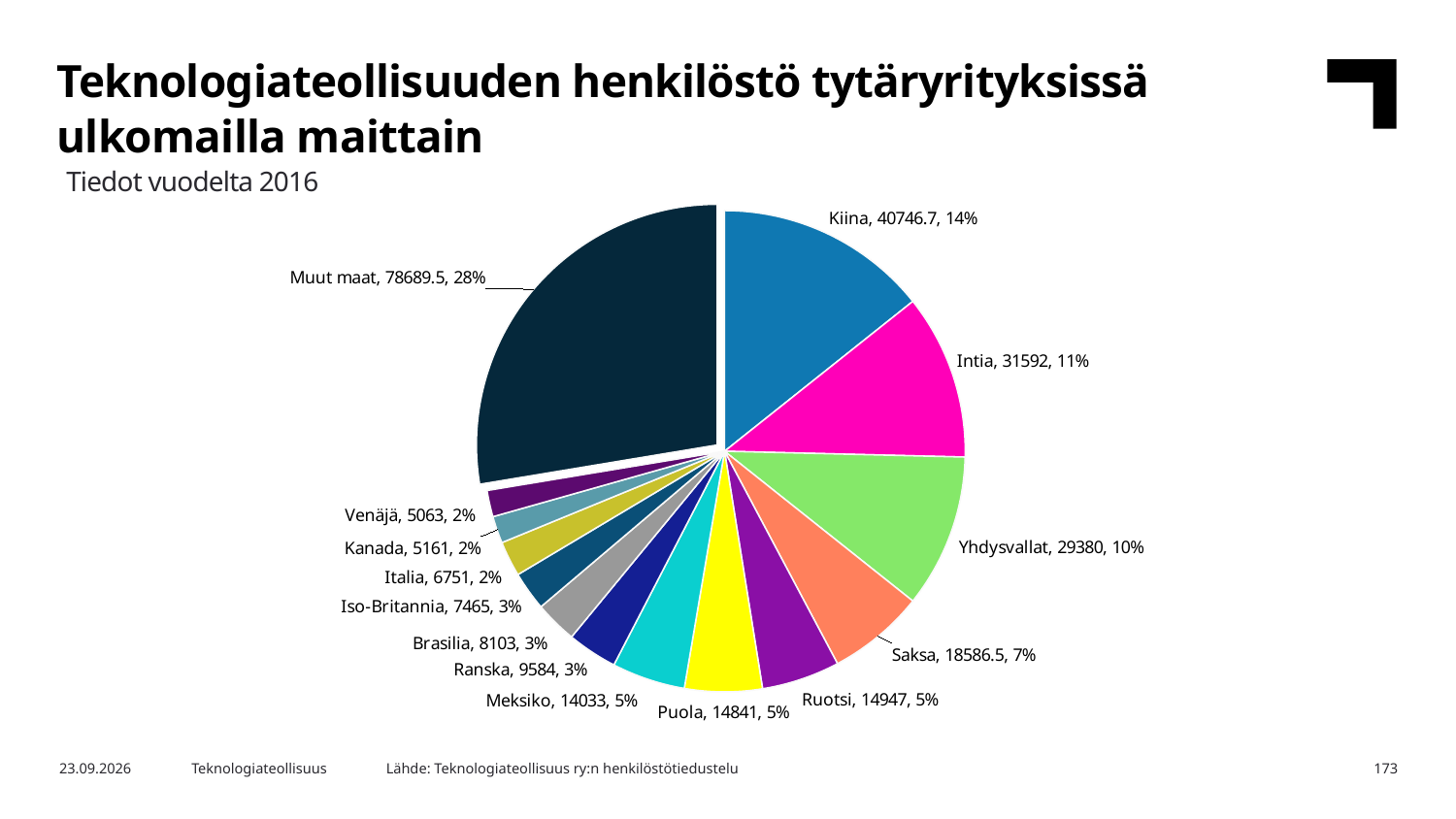
What is the value shown for Meksiko? 14033 What is the difference between the values for Intia and Yhdysvallat? 2212 What type of chart is shown on the slide? Pie chart What share of the pie does Intia represent? 11% What is the value shown for Kiina? 40746.7 What year do the data on the slide refer to? 2016 Which slice of the pie is the smallest? Venäjä What is the value shown for Saksa? 18586.5 How many slices does the pie chart have? 14 Which slice of the pie is the largest? Muut maat Which has a larger value, Ruotsi or Ranska? Ruotsi What share of the pie does Muut maat represent? 28%